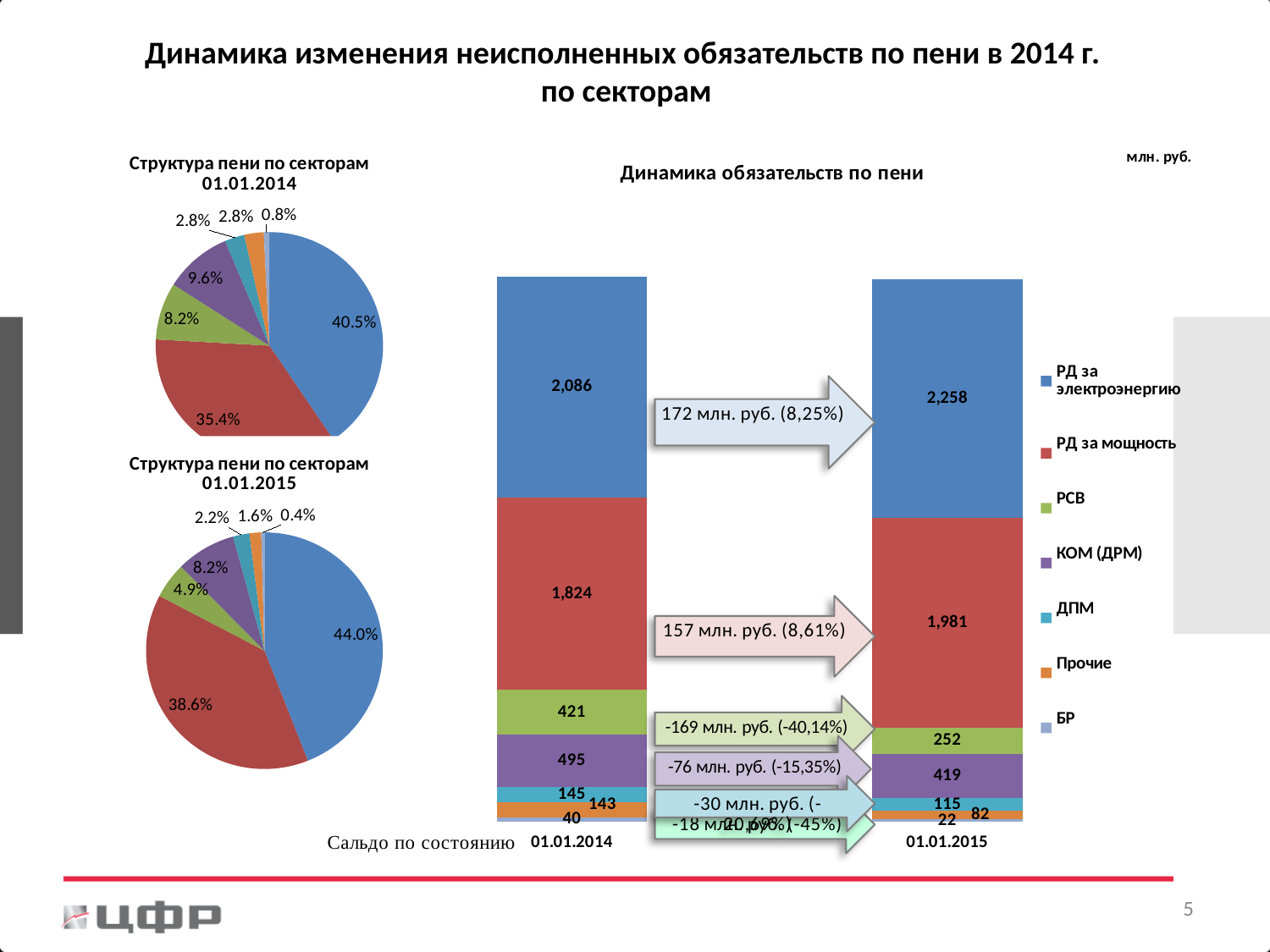
In the chart 'Динамика обязательств по пени', is the value for РСВ larger on 01.01.2014 or on 01.01.2015? 01.01.2014 In the chart 'Динамика обязательств по пени', what is the value for РД за электроэнергию on 01.01.2015? 2,258 In the pie chart 'Структура пени по секторам 01.01.2015', what is the share of the smallest slice? 0.4% How many slices does the pie chart 'Структура пени по секторам 01.01.2015' have? 7 In the chart 'Динамика обязательств по пени', what is the value for РСВ on 01.01.2014? 421 What kind of chart is 'Динамика обязательств по пени'? stacked bar chart In the chart 'Динамика обязательств по пени', what is the value for РД за мощность on 01.01.2014? 1,824 In the chart 'Динамика обязательств по пени', by how much did РД за электроэнергию change from 01.01.2014 to 01.01.2015? 172 How many series does the legend of the chart 'Динамика обязательств по пени' list? 7 In the pie chart 'Структура пени по секторам 01.01.2014', what is the share of the largest slice? 40.5% In the chart 'Динамика обязательств по пени', does the value for РД за мощность rise or fall from 01.01.2014 to 01.01.2015? rise In the chart 'Динамика обязательств по пени', what is the value for КОМ (ДРМ) on 01.01.2015? 419